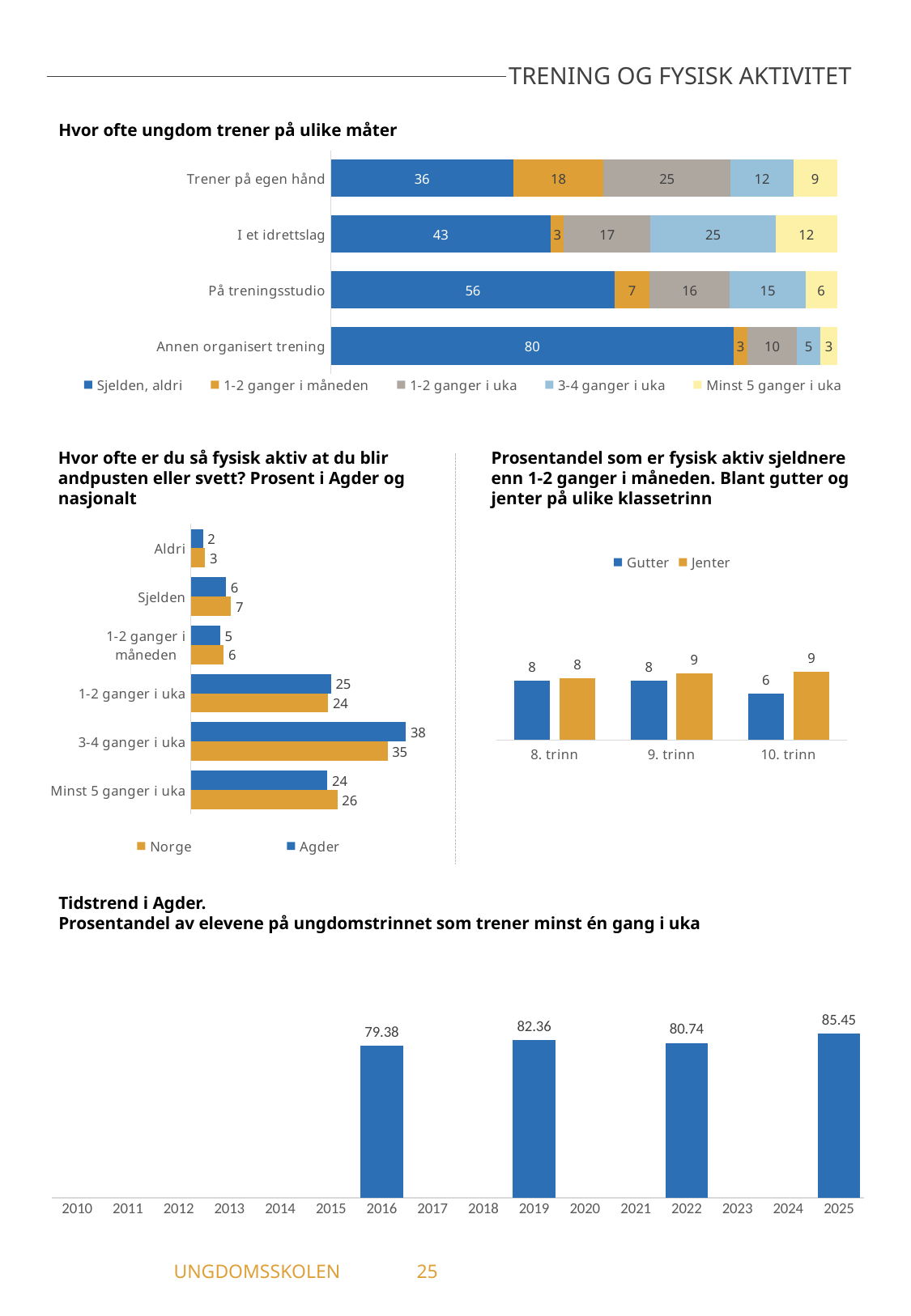
In the chart 'Tidstrend i Agder', which year has the highest value? 2025 What kind of chart is 'Tidstrend i Agder'? Bar chart In the chart 'Hvor ofte ungdom trener på ulike måter', what is the total of the stacked bar for 'Trener på egen hånd'? 100 In the chart 'Hvor ofte ungdom trener på ulike måter', what is the value for 'Sjelden, aldri' for 'Annen organisert trening'? 80 In the chart 'Tidstrend i Agder', what is the value for 2019? 82.36 In the chart 'Hvor ofte er du så fysisk aktiv at du blir andpusten eller svett?', what is the difference between Norge and Agder for 'Minst 5 ganger i uka'? 2 In the chart 'Hvor ofte ungdom trener på ulike måter', how many series does the legend list? 5 In the chart 'Hvor ofte er du så fysisk aktiv at du blir andpusten eller svett?', how many categories are shown? 6 In the chart 'Hvor ofte er du så fysisk aktiv at du blir andpusten eller svett?', what is the value for Agder for '3-4 ganger i uka'? 38 In the chart 'Prosentandel som er fysisk aktiv sjeldnere enn 1-2 ganger i måneden', what is the value for Gutter in 10. trinn? 6 In the chart 'Prosentandel som er fysisk aktiv sjeldnere enn 1-2 ganger i måneden', which is larger in 9. trinn, Gutter or Jenter? Jenter In the chart 'Hvor ofte ungdom trener på ulike måter', which category has the highest value for 'Minst 5 ganger i uka'? I et idrettslag